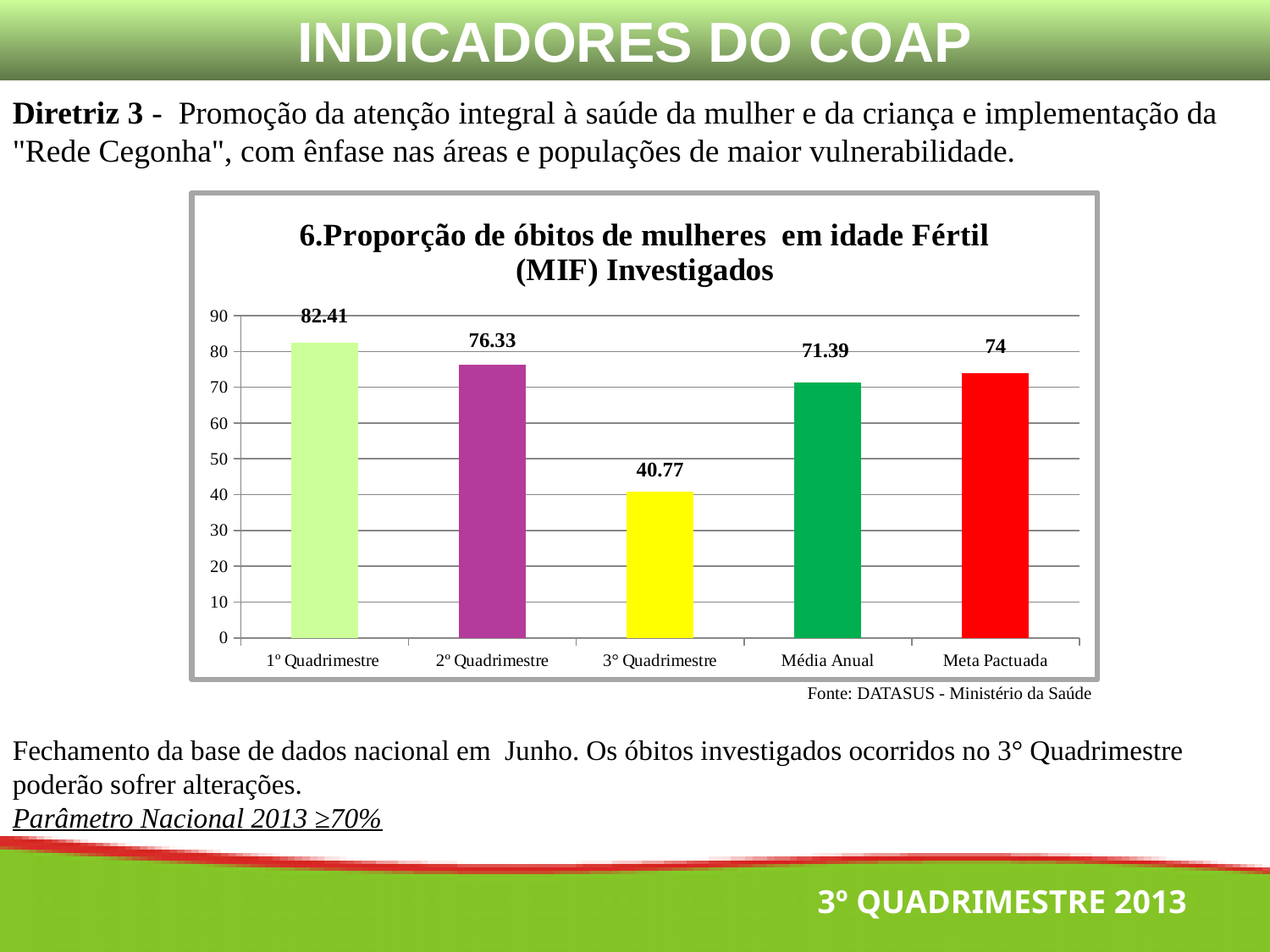
What is the value for Média Anual? 71.39 What is the value for 1º Quadrimestre? 82.41 Which category has the lowest value? 3° Quadrimestre What is the value for 3° Quadrimestre? 40.77 Which category has the highest value? 1º Quadrimestre What kind of chart is shown on the slide? Bar chart What is the source cited below the chart? DATASUS - Ministério da Saúde What is the value for Meta Pactuada? 74 Which is larger, the value for 2º Quadrimestre or the value for Meta Pactuada? 2º Quadrimestre What is the difference between the values for 1º Quadrimestre and 2º Quadrimestre? 6.08 How many categories are shown on the x axis? 5 What is the difference between the Meta Pactuada and the Média Anual? 2.61